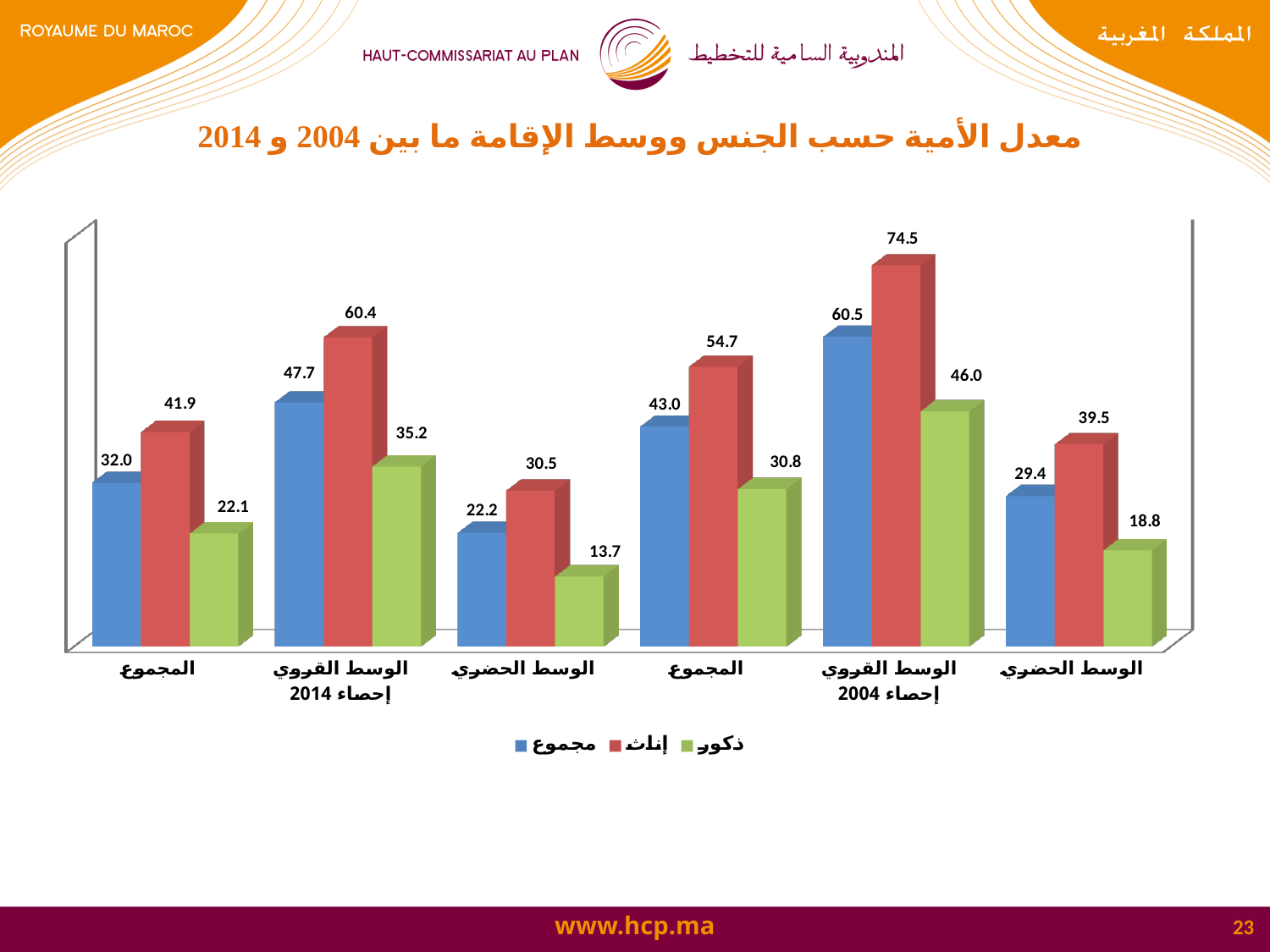
What is the value for إناث (females) in الوسط القروي for إحصاء 2004? 74.5 What is the value for ذكور (males) in الوسط الحضري for إحصاء 2014? 13.7 Which is larger: the إناث (females) value for المجموع in إحصاء 2014 or the ذكور (males) value for الوسط القروي in إحصاء 2004? ذكور (males) for الوسط القروي in إحصاء 2004 (46.0) Which category group has the lowest ذكور (males) value? الوسط الحضري (إحصاء 2014) How many category groups are shown on the x axis? 6 What is the difference between the إناث (females) and ذكور (males) values for المجموع in إحصاء 2014? 19.8 Which category group has the highest إناث (females) value? الوسط القروي (إحصاء 2004) What is the difference between the مجموع (total) value for الوسط القروي in إحصاء 2004 and in إحصاء 2014? 12.8 Which colour represents the إناث (females) series in the legend? red How many series does the legend list? 3 What type of chart is shown on the slide? bar chart What is the value for مجموع (total) in المجموع for إحصاء 2004? 43.0